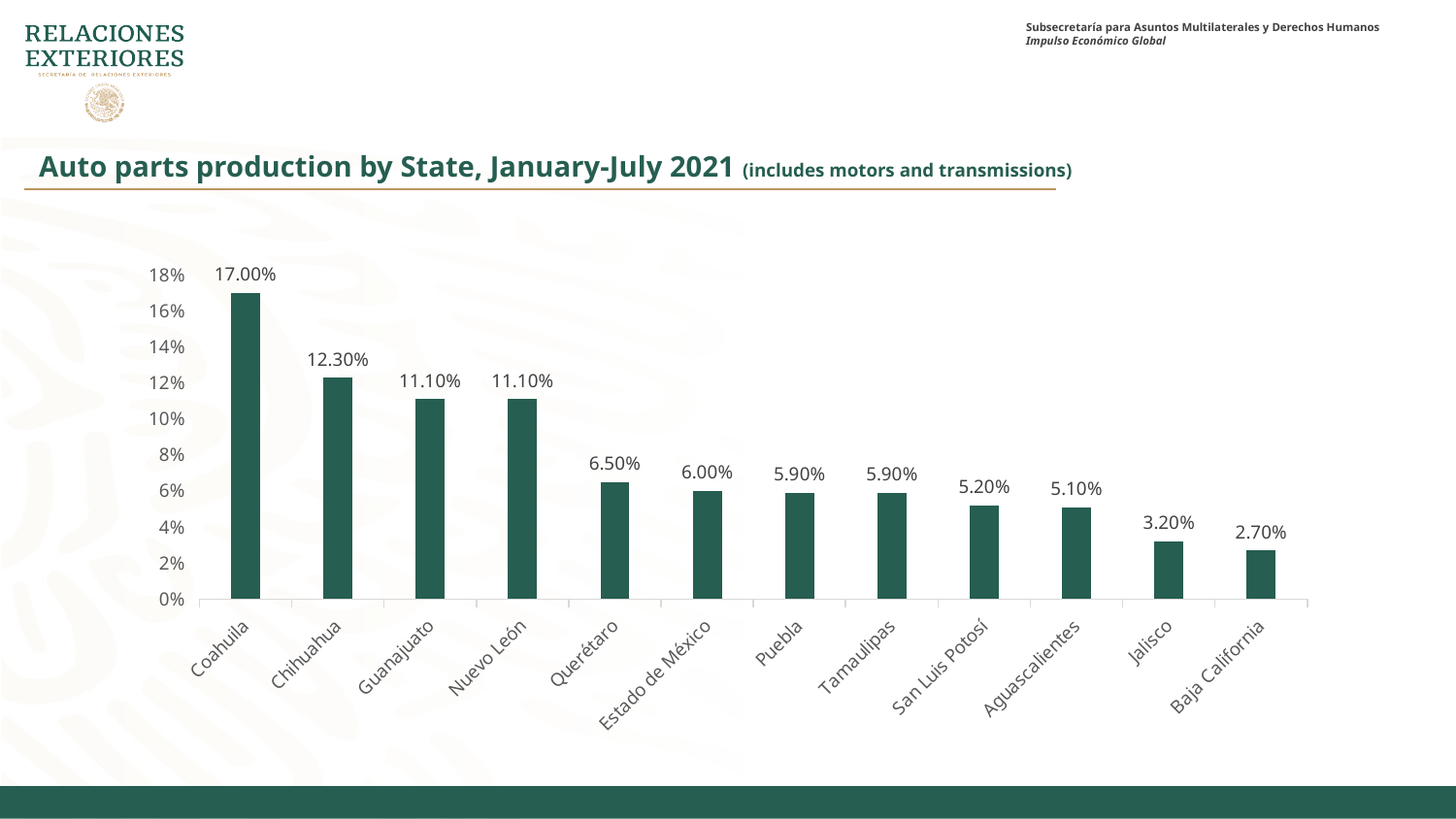
Is the value for Guanajuato greater or less than 10%? greater What is the difference between the values for Coahuila and Chihuahua? 4.70% Which is larger, the value for Estado de México or the value for Aguascalientes? Estado de México How many states are shown in the chart? 12 Which state has the lowest auto parts production share? Baja California What is the value for Coahuila? 17.00% What is the value for Baja California? 2.70% What kind of chart is shown on the slide? Bar chart What is the value for Querétaro? 6.50% What is the difference between the values for Jalisco and Baja California? 0.50% Do the values rise or fall from left to right along the x axis? Fall Which state has the highest auto parts production share? Coahuila